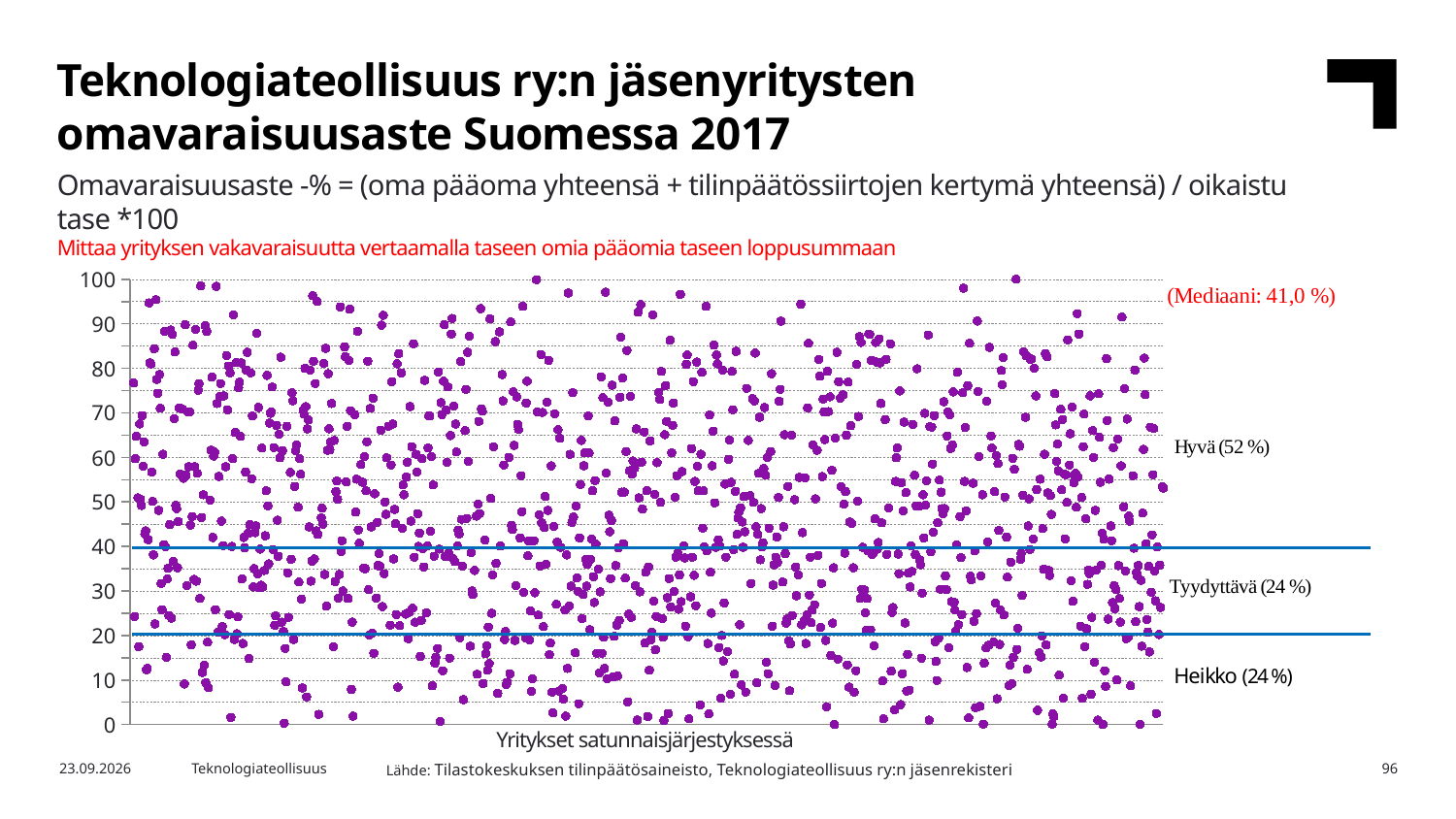
What is the label of the horizontal axis of the chart? Yritykset satunnaisjärjestyksessä At which two vertical-axis values are the horizontal threshold lines drawn on the chart? 40 and 20 How many categories (Hyvä, Tyydyttävä, Heikko) are labelled on the chart? 3 What share of companies falls into the Hyvä category? 52 % What share of companies falls into the Heikko category? 24 % What kind of chart is shown on the slide? Scatter chart Which category has the largest share of companies: Hyvä, Tyydyttävä or Heikko? Hyvä What share of companies falls into the Tyydyttävä category? 24 % What is the difference in percentage points between the Hyvä share and the Heikko share? 28 What is the highest value shown on the vertical axis of the chart? 100 What is the median (Mediaani) equity ratio shown on the chart? 41,0 % Is the share of companies in the Hyvä category larger or smaller than the share in the Tyydyttävä category? Larger